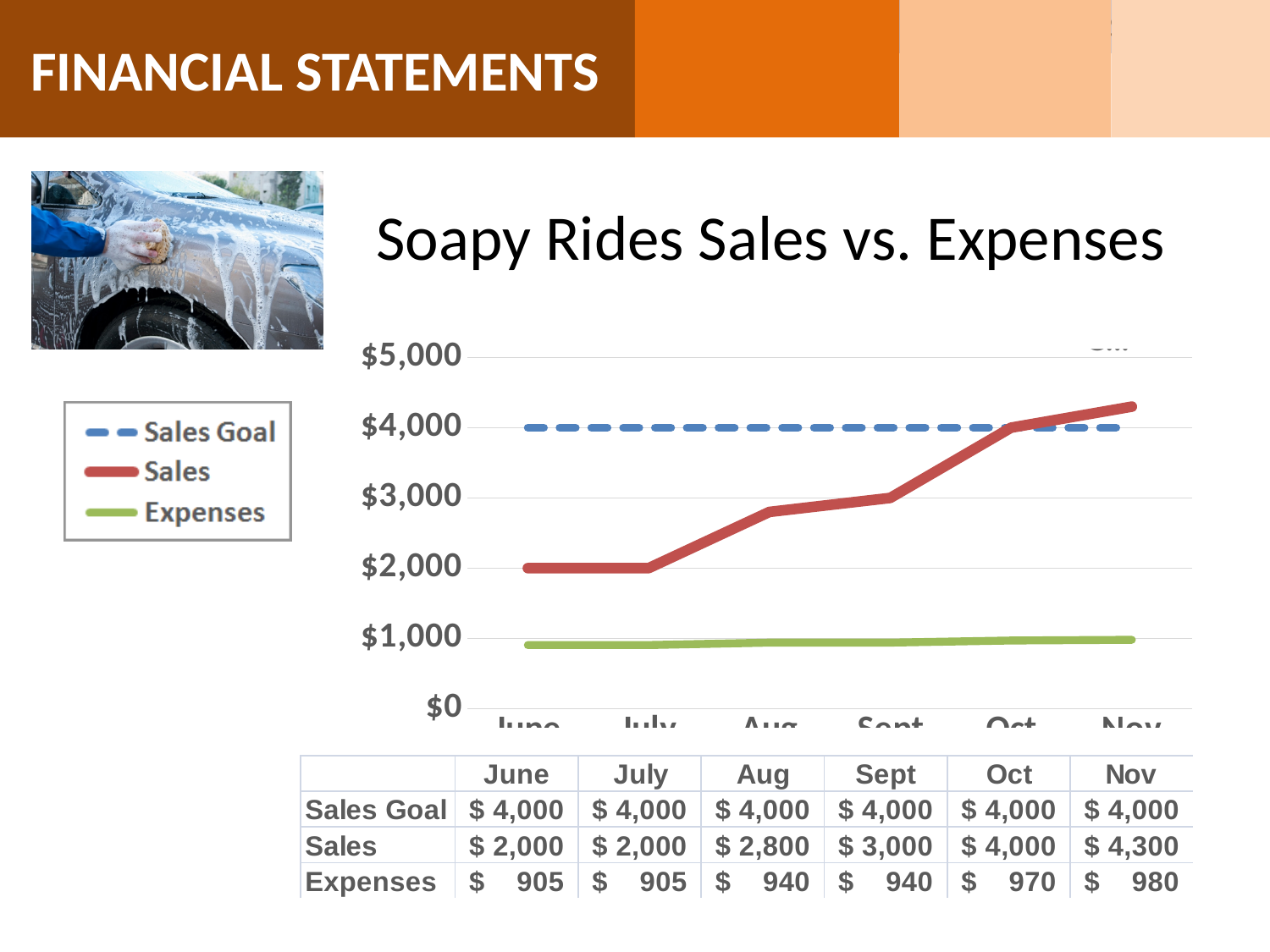
How many series does the legend list? 3 What is the title of the chart? Soapy Rides Sales vs. Expenses What is the Sales Goal value for Sept? $4,000 What type of chart is shown on the slide? line chart In which month is Sales highest? Nov In which month is Expenses lowest (first occurrence)? June Which is larger in Nov, Sales or Sales Goal? Sales How many months are plotted along the x axis? 6 What is the Expenses value for Aug? $940 What is the Sales value for Nov? $4,300 What is the difference between Sales and Expenses in Oct? $3,030 Do Sales rise or fall from June to Nov? rise